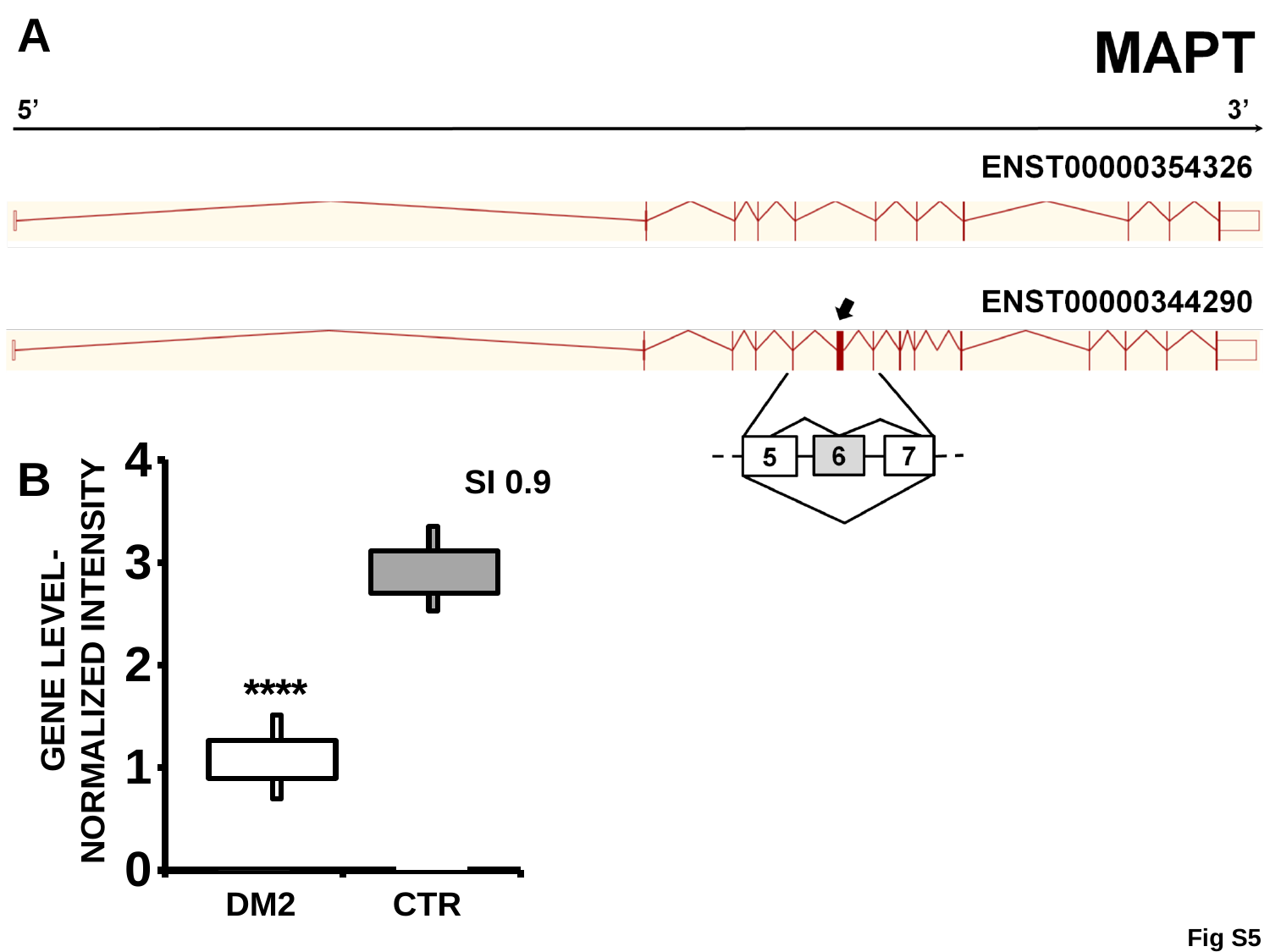
In panel B, what is the label of the y axis? GENE LEVEL-NORMALIZED INTENSITY In panel B, which group shows the lowest gene level-normalized intensity? DM2 In panel B, what SI value is printed above the CTR box? SI 0.9 In panel B, which group has the higher gene level-normalized intensity, DM2 or CTR? CTR In panel B, which group shows the highest gene level-normalized intensity? CTR In panel B, what kind of chart is shown? box plot In panel B, is the value for CTR greater or less than 2? greater In panel B, how many groups are plotted on the x axis? 2 In panel B, is the value for CTR greater or less than 4? less In panel B, is the value for DM2 greater or less than 2? less